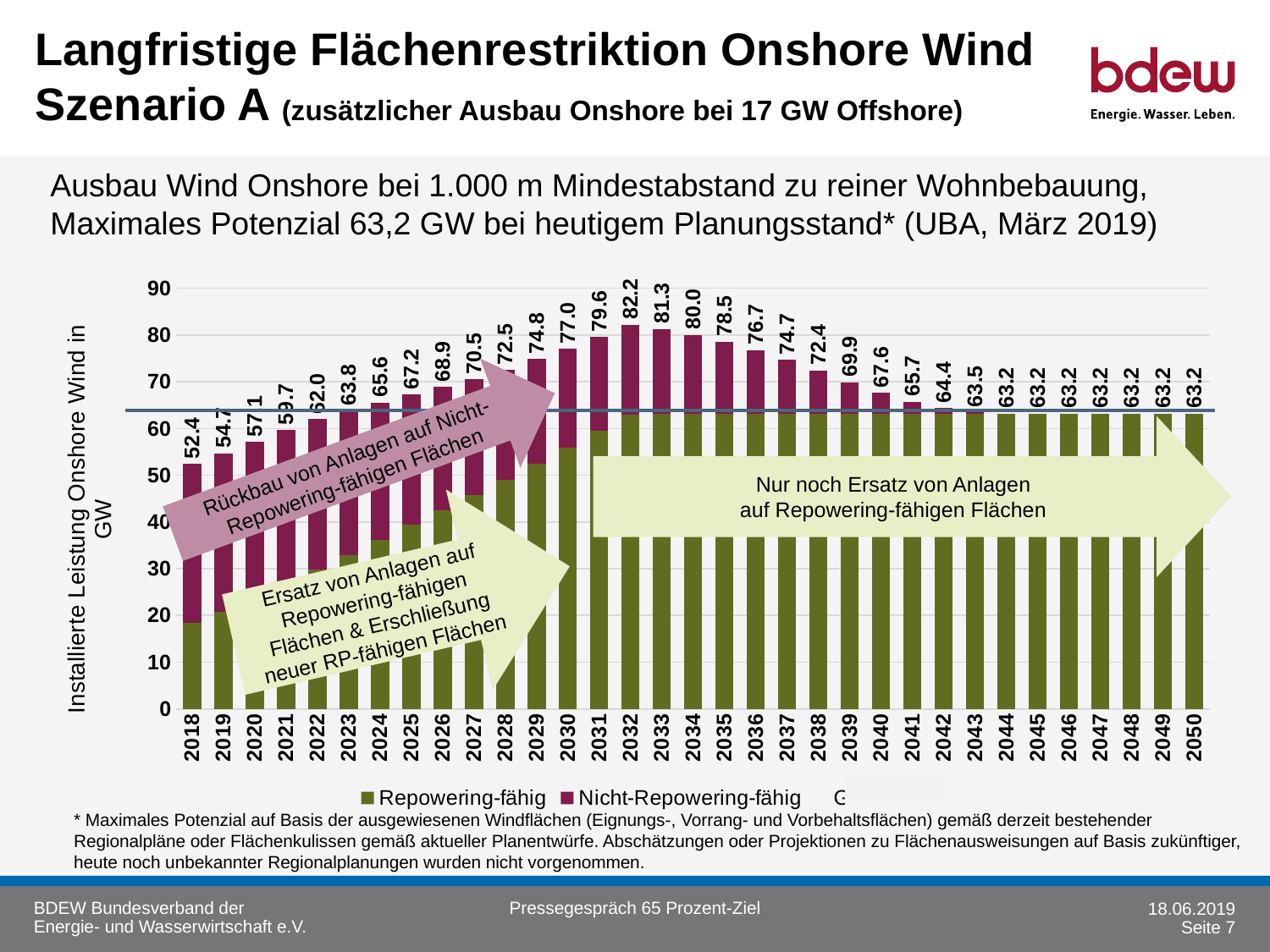
Do the total values rise or fall from 2018 to 2032? rise What is the total value labelled for the 2032 bar? 82.2 What is the total value labelled for 2040? 67.6 Which year has the lowest total installed capacity? 2018 What is the total value labelled for 2050? 63.2 Which year has a larger total, 2025 or 2041? 2025 Which year has the highest total installed capacity? 2032 Is the Repowering-fähig (green) value for 2030 greater or less than 50? greater What is the total installed onshore wind capacity shown for 2018? 52.4 How many years are shown on the x axis? 33 What is the difference between the total for 2032 and the total for 2050? 19.0 What kind of chart is shown on the slide? stacked bar chart